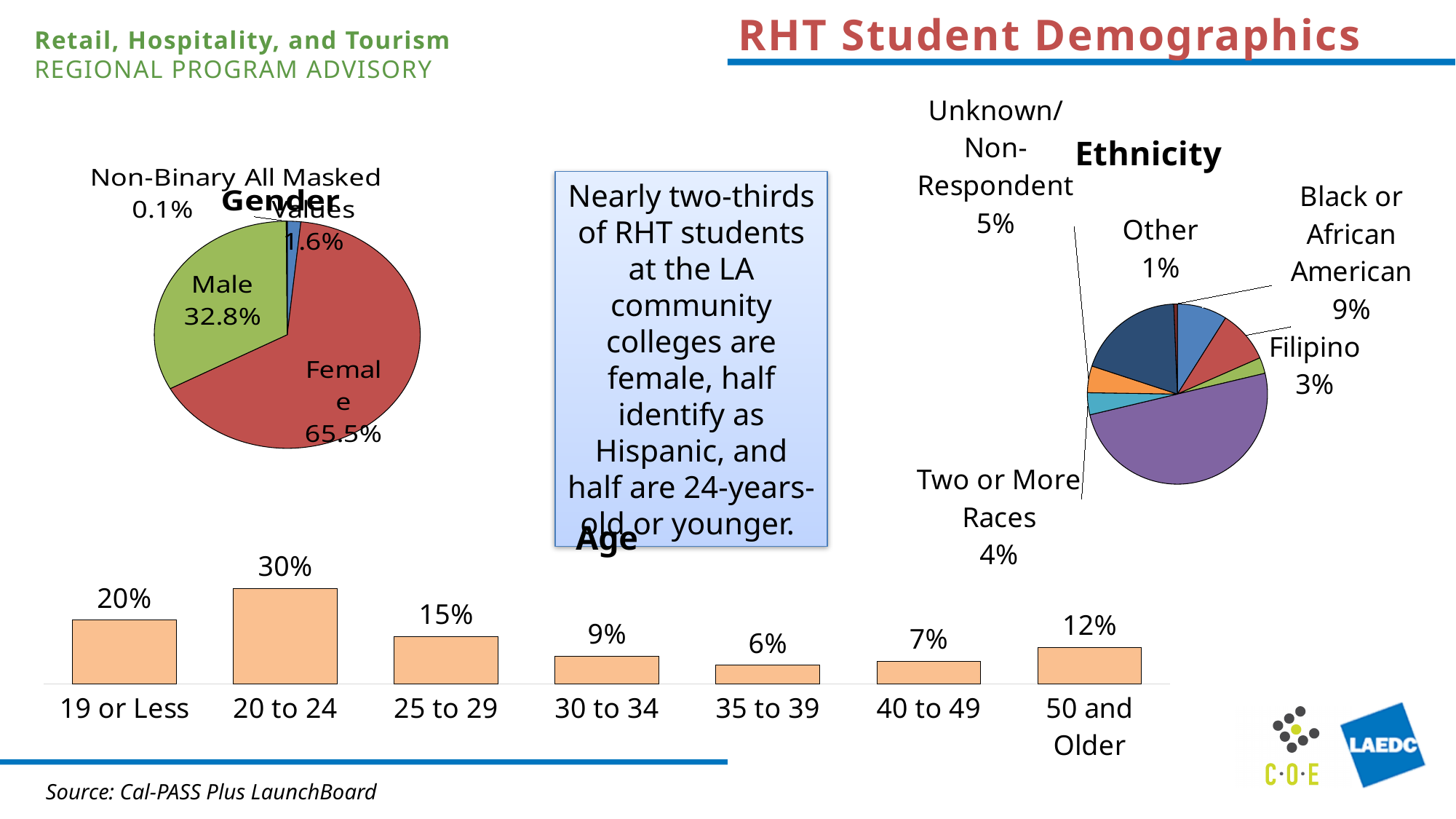
In the Age chart, what is the value for the 50 and Older group? 12% How many age groups are shown in the Age chart? 7 In the Age chart, which age group has the lowest percentage? 35 to 39 In the Ethnicity pie chart, what share is Black or African American? 9% In the Age chart, what is the difference between the 19 or Less group and the 25 to 29 group? 5% In the Age chart, what percentage of RHT students are 20 to 24 years old? 30% In the Gender pie chart, what percentage of RHT students are female? 65.5% In the Age chart, which age group has the highest percentage? 20 to 24 In the Ethnicity pie chart, which is larger: the Filipino share or the Two or More Races share? Two or More Races In the Age chart, which is larger: the value for 30 to 34 or the value for 40 to 49? 30 to 34 In the Gender pie chart, what is the difference between the Female and Male shares? 32.7% What kind of chart is the Age chart? Bar chart